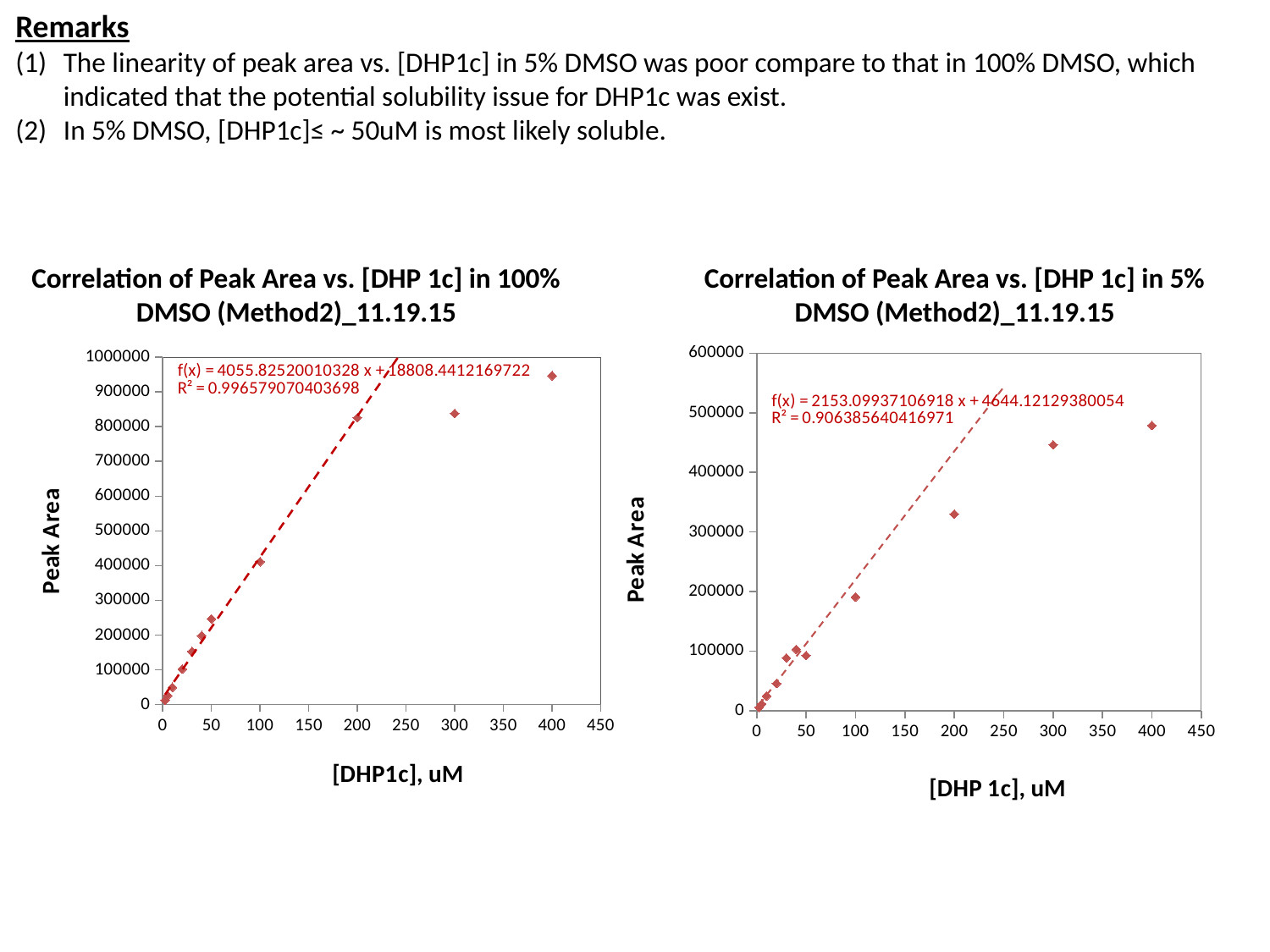
In the left chart (100% DMSO), is the peak area at 400 uM greater or less than 900000? greater What type of chart is the left chart, 'Correlation of Peak Area vs. [DHP 1c] in 100% DMSO'? Scatter chart In the right chart (5% DMSO), is the peak area at 200 uM greater or less than 300000? greater In the right chart (5% DMSO), is the peak area at 400 uM greater or less than 500000? less Which chart has the higher R² value, the 100% DMSO chart or the 5% DMSO chart? The 100% DMSO chart In the left chart (100% DMSO), what is the R² value printed for the trendline? 0.996579070403698 In the right chart (5% DMSO), what is the R² value printed for the trendline? 0.906385640416971 In the right chart (5% DMSO), what is the trendline equation shown? f(x) = 2153.09937106918 x + 4644.12129380054 In the right chart (5% DMSO), does the peak area generally rise or fall as [DHP 1c] increases? Rise In the left chart (100% DMSO), what is the trendline equation shown? f(x) = 4055.82520010328 x + 18808.4412169722 What is the y-axis label on the left chart? Peak Area In the left chart (100% DMSO), at which [DHP1c] concentration is the peak area highest? 400 uM